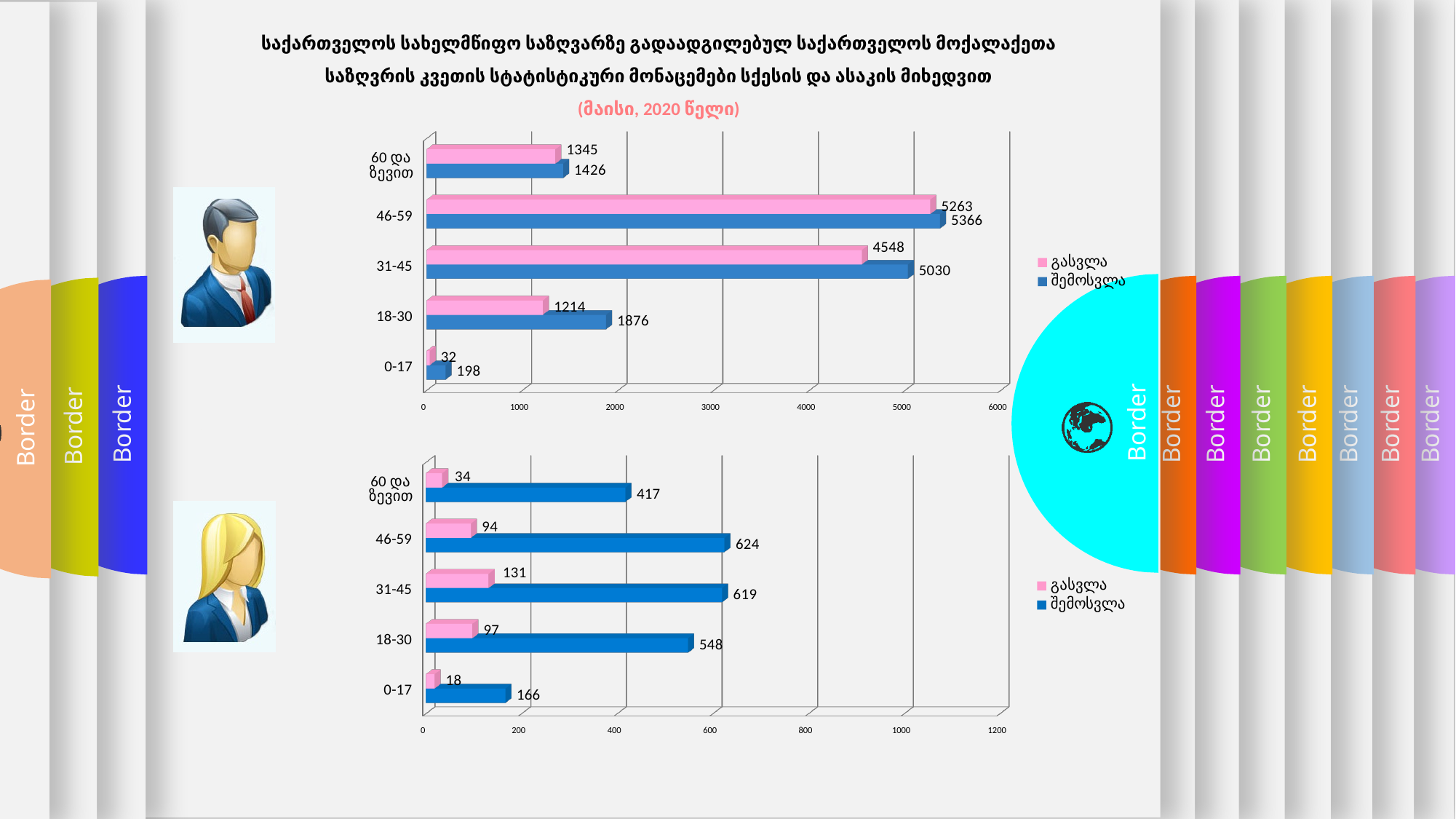
How many series does the legend of the bottom chart list? 2 In the top chart, what is the value of გასვლა for the 18-30 age group? 1214 In the bottom chart, which age group has the lowest შემოსვლა value? 0-17 In the top chart, which age group has the highest გასვლა value? 46-59 In the top chart, what is the value of შემოსვლა for the 46-59 age group? 5366 In the bottom chart, what is the difference between შემოსვლა and გასვლა for the 46-59 age group? 530 In the bottom chart, what is the value of შემოსვლა for the 18-30 age group? 548 How many age groups are shown in the top chart? 5 In the bottom chart, which is larger: გასვლა for 31-45 or გასვლა for 46-59? გასვლა for 31-45 In the bottom chart, what is the value of გასვლა for the 0-17 age group? 18 In the top chart, what is the difference between შემოსვლა and გასვლა for the 31-45 age group? 482 What type of chart is the top chart? Bar chart